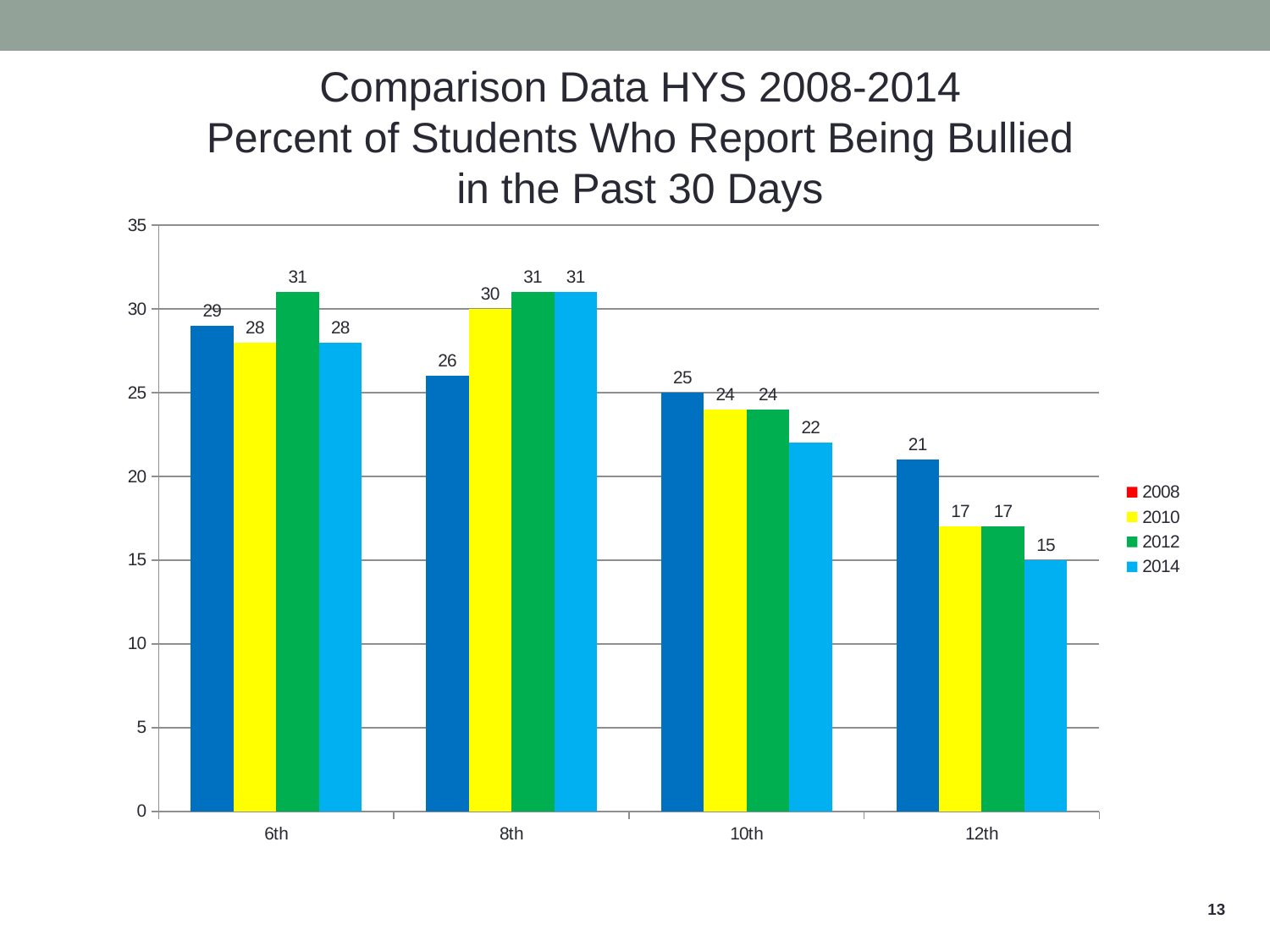
What is the difference between the 2008 and 2014 values for 12th grade? 6 How many grade categories are shown on the x axis? 4 Which year has the highest value for 8th grade? 2012 and 2014 (both 31) Which grade has the lowest value in 2014? 12th What kind of chart is shown on the slide? bar chart How many years does the legend list? 4 Is the 2014 value for 10th grade greater or less than 25? less What is the value for 12th grade in 2014? 15 Do the 2008 values rise or fall from 6th grade to 12th grade? fall What is the value for 8th grade in 2008? 26 Which is larger, the 2010 value for 8th grade or the 2010 value for 10th grade? 8th grade What percent of 6th graders reported being bullied in 2012? 31